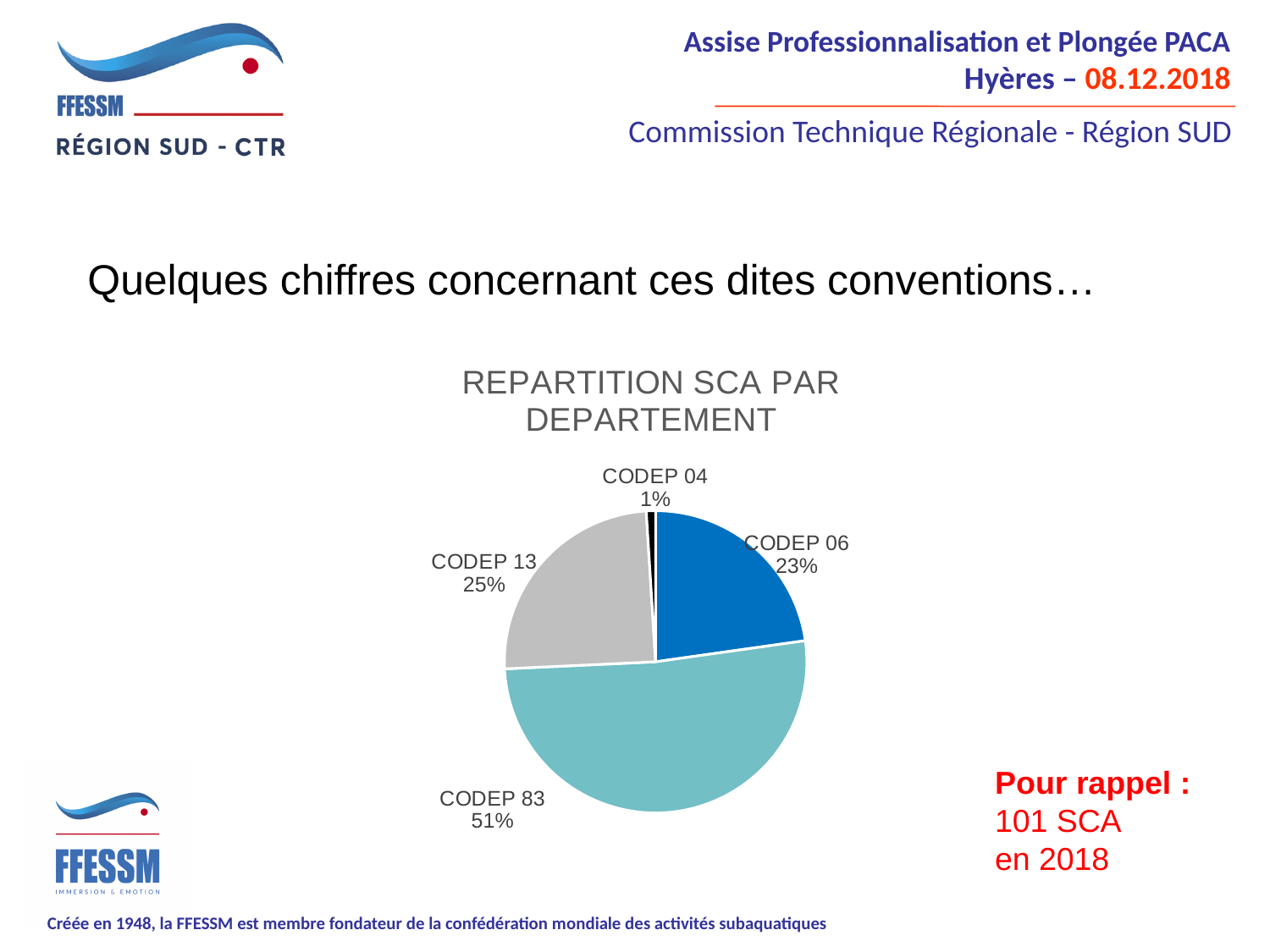
How many departments (slices) are shown in the pie chart? 4 What share of the pie does CODEP 83 represent? 51% What is the title of the chart? REPARTITION SCA PAR DEPARTEMENT What is the difference in percentage points between the shares of CODEP 83 and CODEP 13? 26 What is the difference in percentage points between the shares of CODEP 13 and CODEP 06? 2 Which department has the smallest share of SCA? CODEP 04 Which has a larger share, CODEP 83 or CODEP 06? CODEP 83 What kind of chart is shown on the slide? Pie chart What share of the pie does CODEP 06 represent? 23% What share of the pie does CODEP 04 represent? 1% Which department has the largest share of SCA? CODEP 83